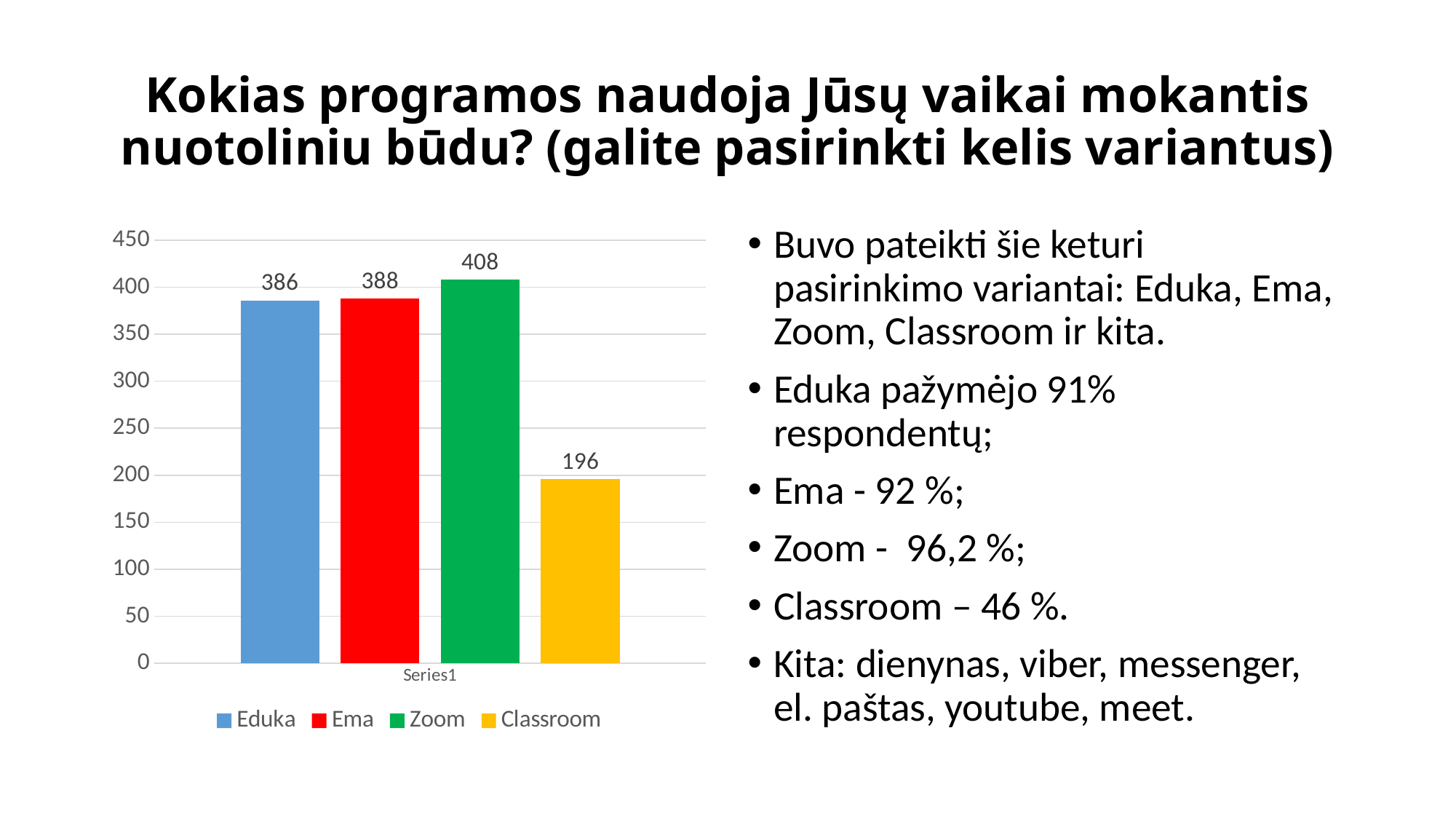
What is the difference between the values for Ema and Eduka? 2 What is the value for Eduka? 386 What is the value for Zoom? 408 Which is larger, the value for Eduka or the value for Classroom? Eduka What colour is the bar for Ema? red How many series does the legend list? 4 What is the difference between the values for Zoom and Classroom? 212 What is the value for Classroom? 196 Which program has the highest value? Zoom What kind of chart is shown on the slide? bar chart Is the value for Classroom greater or less than 250? less Which program has the lowest value? Classroom